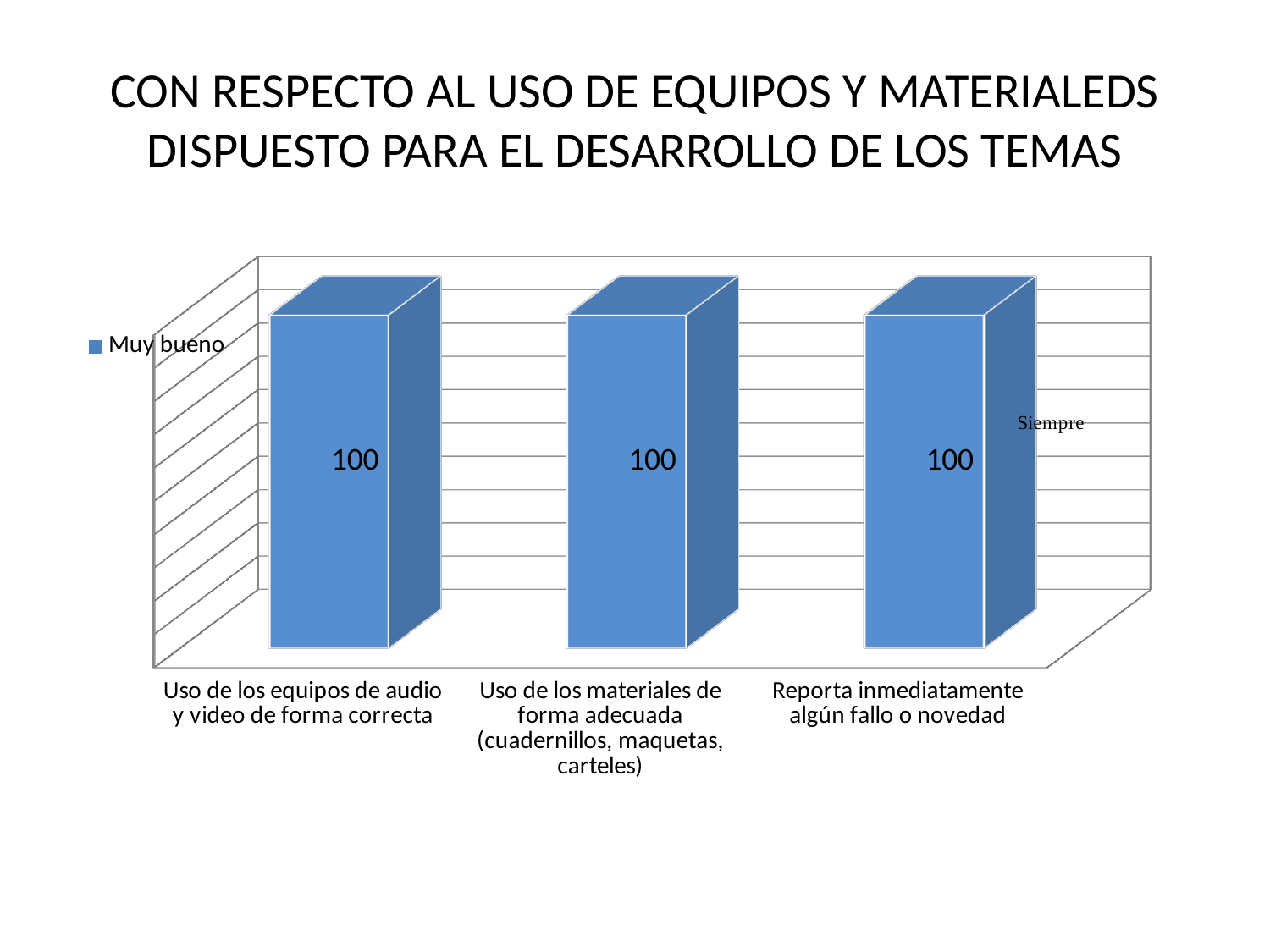
What kind of chart is shown on the slide? Bar chart How many categories are shown on the x axis of the chart? 3 What is the value for "Reporta inmediatamente algún fallo o novedad"? 100 How many series does the legend list? 1 What is the value for "Uso de los equipos de audio y video de forma correcta"? 100 What is the title of the slide containing the chart? CON RESPECTO AL USO DE EQUIPOS Y MATERIALEDS DISPUESTO PARA EL DESARROLLO DE LOS TEMAS What is the difference between the value for "Uso de los equipos de audio y video de forma correcta" and the value for "Reporta inmediatamente algún fallo o novedad"? 0 What series name is shown in the chart legend? Muy bueno Are all three bars in the chart equal in value? Yes Do the values rise, fall, or stay the same across the categories from left to right? Stay the same What is the value for "Uso de los materiales de forma adecuada (cuadernillos, maquetas, carteles)"? 100